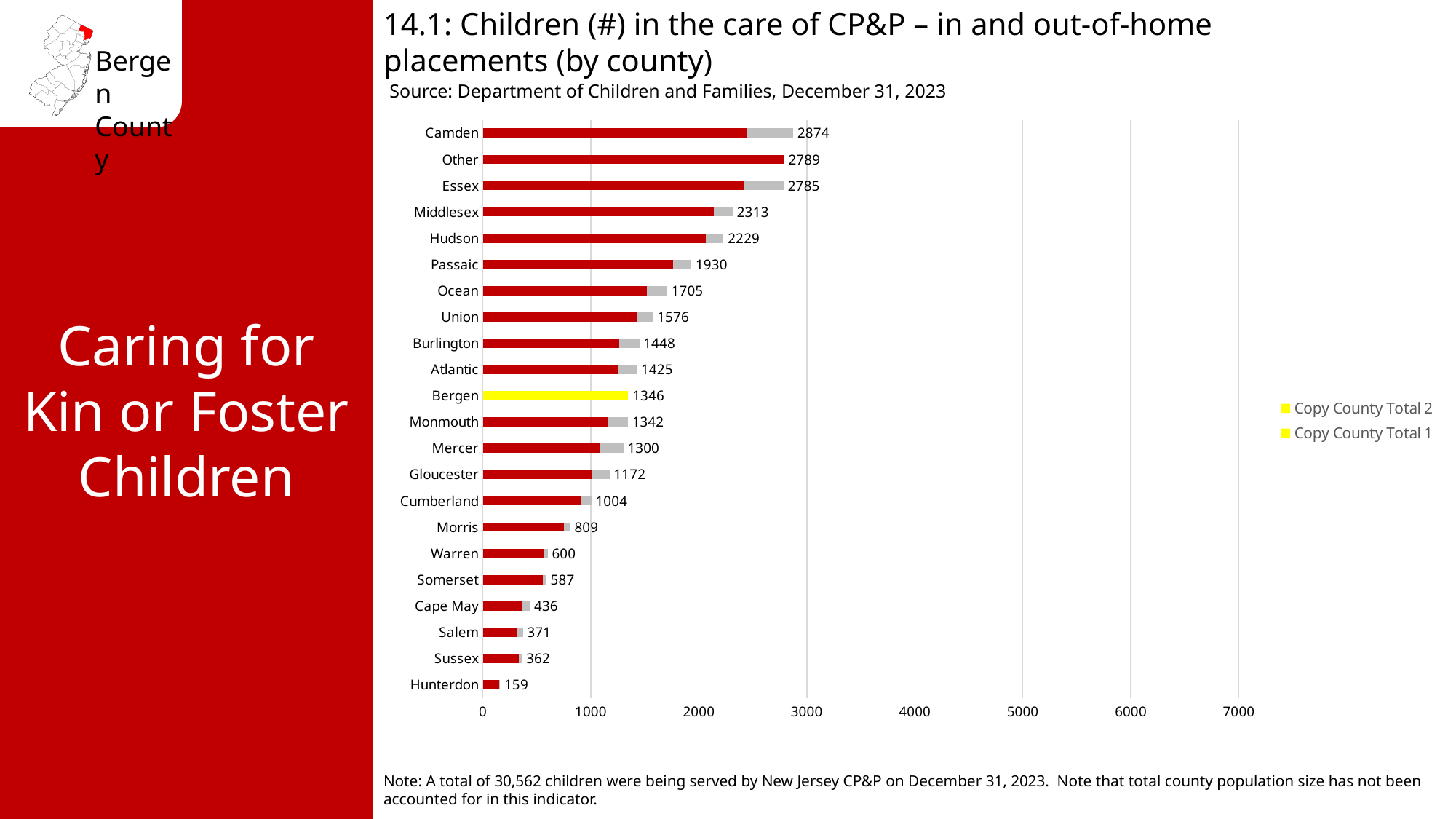
What kind of chart is shown on the slide? Bar chart Which has a larger value, Middlesex or Hudson? Middlesex What is the difference between the values for Bergen and Monmouth? 4 What is the value shown for Passaic? 1930 How many counties (categories) are shown on the chart? 22 Which county has the highest number of children in the care of CP&P? Camden What is the total number of children in the care of CP&P for Camden? 2874 Which county has the lowest number of children in the care of CP&P? Hunterdon What is the difference between the values for Camden and Hunterdon? 2715 What is the value shown for Bergen? 1346 How many series does the legend list? 2 What is the value shown for Hunterdon? 159